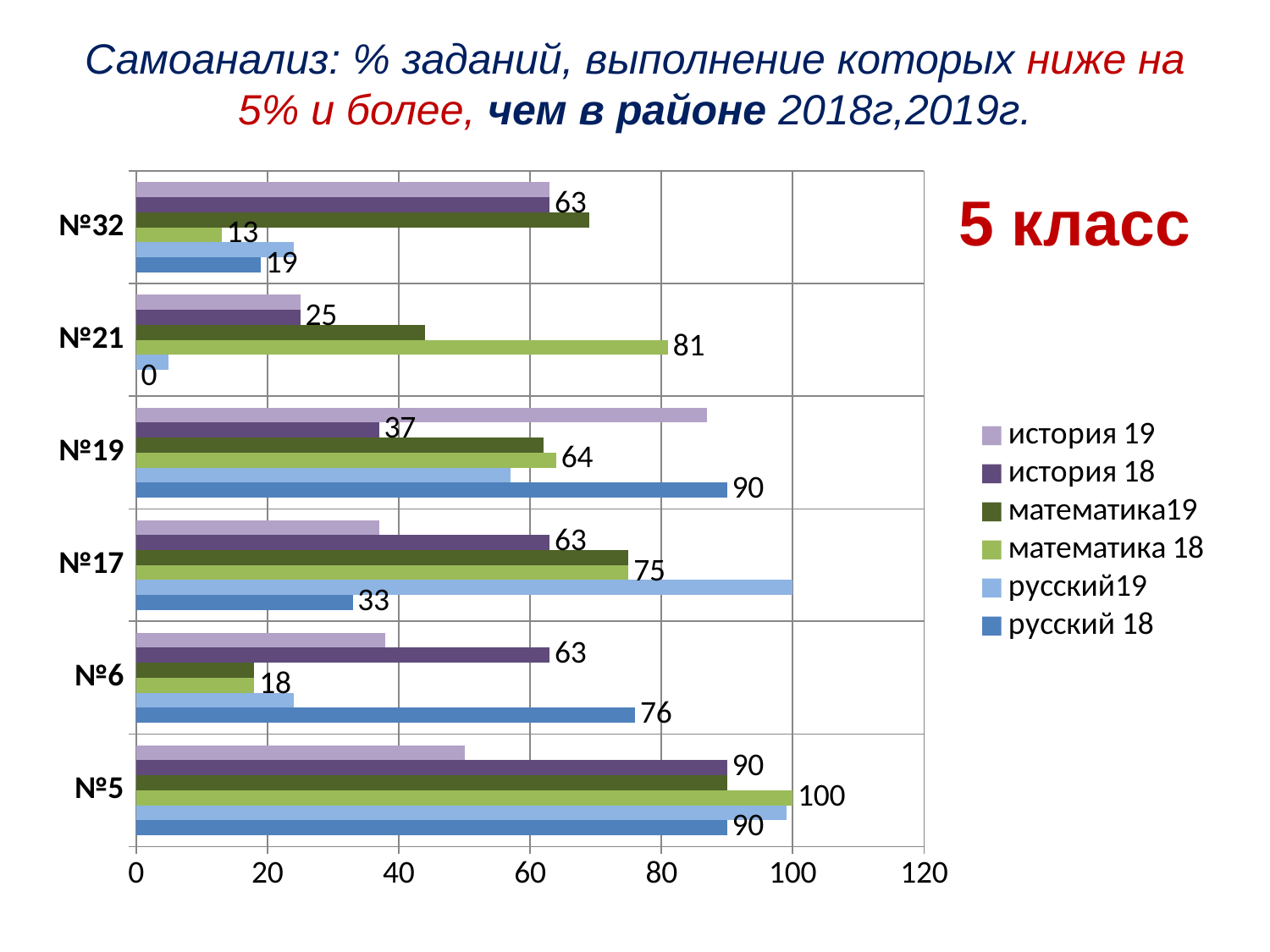
Is the value for русский19 in category №21 greater or less than 20? less How many categories are shown on the chart? 6 How many series does the legend list? 6 In category №6, which is larger: история 18 or математика 18? история 18 What is the value for математика 18 in category №21? 81 Which category has the highest value for математика 18? №5 In category №17, what is the difference between математика 18 and русский 18? 42 Is the value for история 19 in category №19 greater or less than 80? greater What is the value for история 18 in category №5? 90 Which category has the lowest value for русский 18? №21 What is the value for русский 18 in category №21? 0 What is the value for русский 18 in category №19? 90